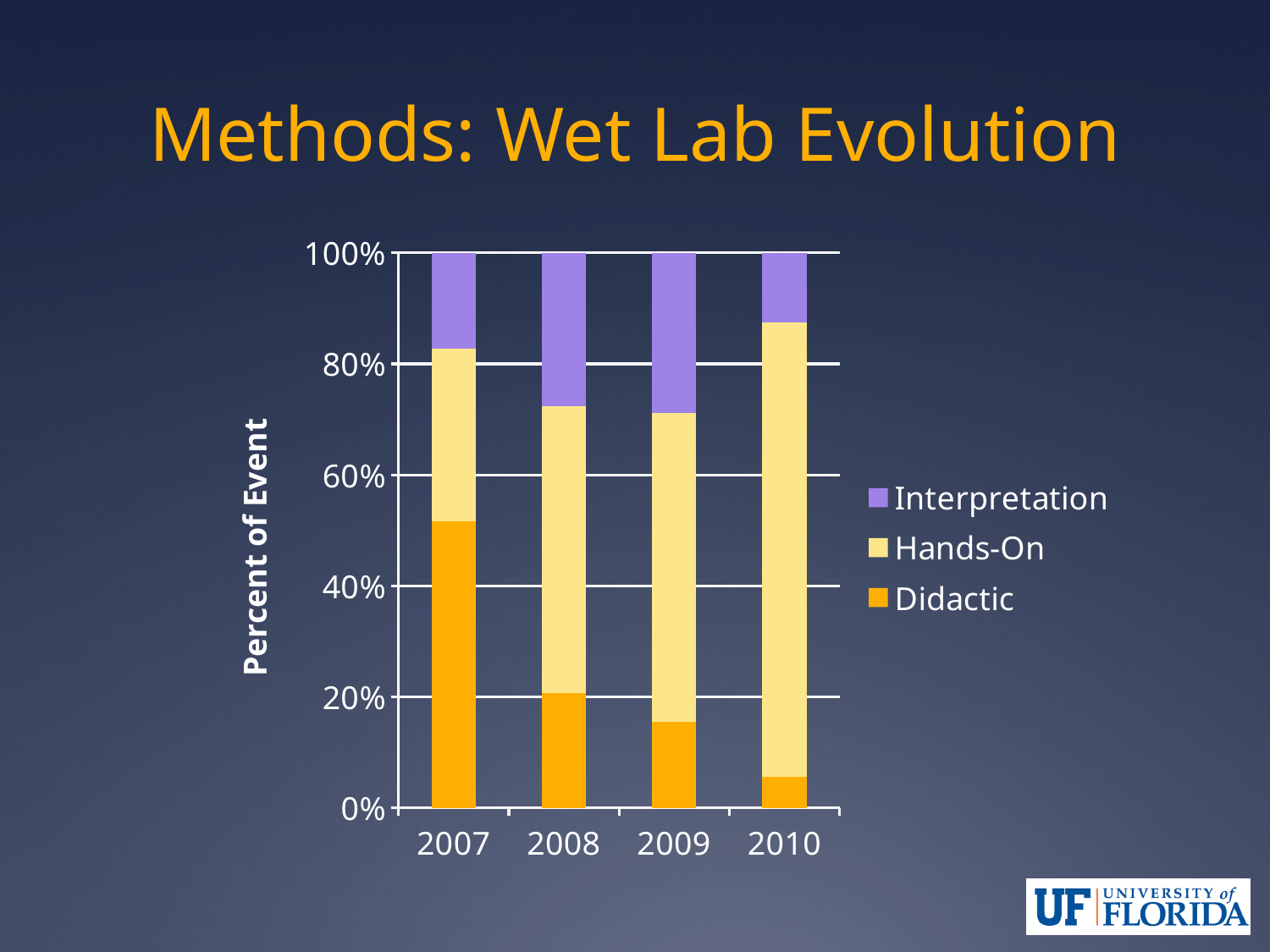
Which is larger, the Hands-On segment for 2010 or the Hands-On segment for 2007? 2010 In which year is the Didactic segment the smallest? 2010 Does the Didactic share rise or fall from 2007 to 2010? fall Is the Didactic value for 2007 greater or less than 40%? greater What is the title of the slide containing the chart? Methods: Wet Lab Evolution What is the label on the vertical axis of the chart? Percent of Event How many years are shown on the x axis of the chart? 4 How many series does the chart's legend list? 3 Is the Hands-On value for 2010 greater or less than 60%? greater In which year is the Didactic segment the largest? 2007 What kind of chart is shown on the slide? stacked bar chart Is the Didactic value for 2010 greater or less than 20%? less